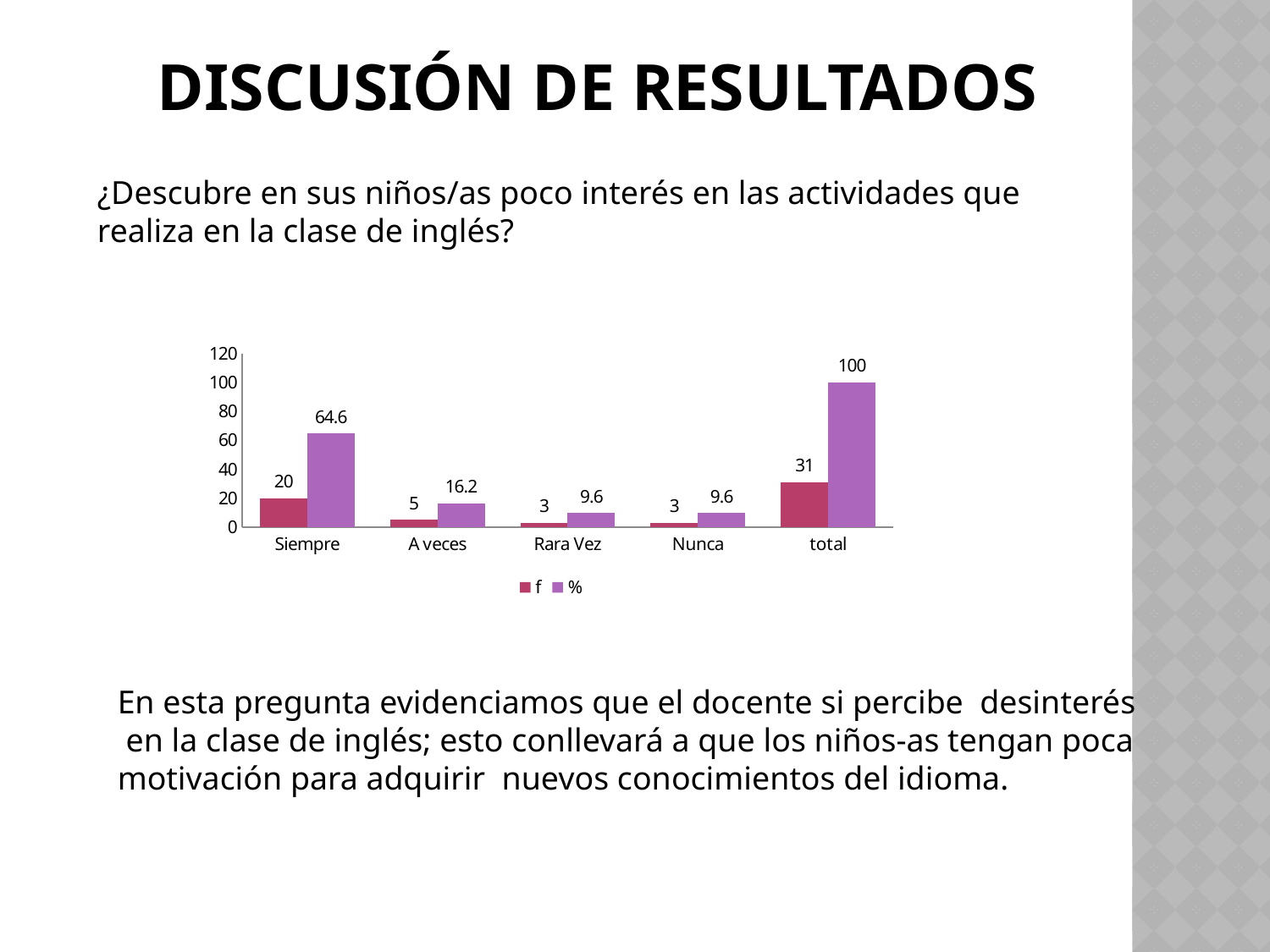
How many categories are shown on the x axis? 5 What is the value of the f series for Siempre? 20 What is the value of the % series for A veces? 16.2 How many series does the legend list? 2 Which category has the lowest f value? Rara Vez and Nunca (both 3) What is the value of the % series for Siempre? 64.6 What is the value of the f series for total? 31 What kind of chart is shown on the slide? Bar chart Which is larger, the f value for A veces or the f value for Nunca? A veces Is the % value for Siempre greater or less than 60? greater Excluding the total category, which category has the highest % value? Siempre What is the difference between the % values for Siempre and A veces? 48.4